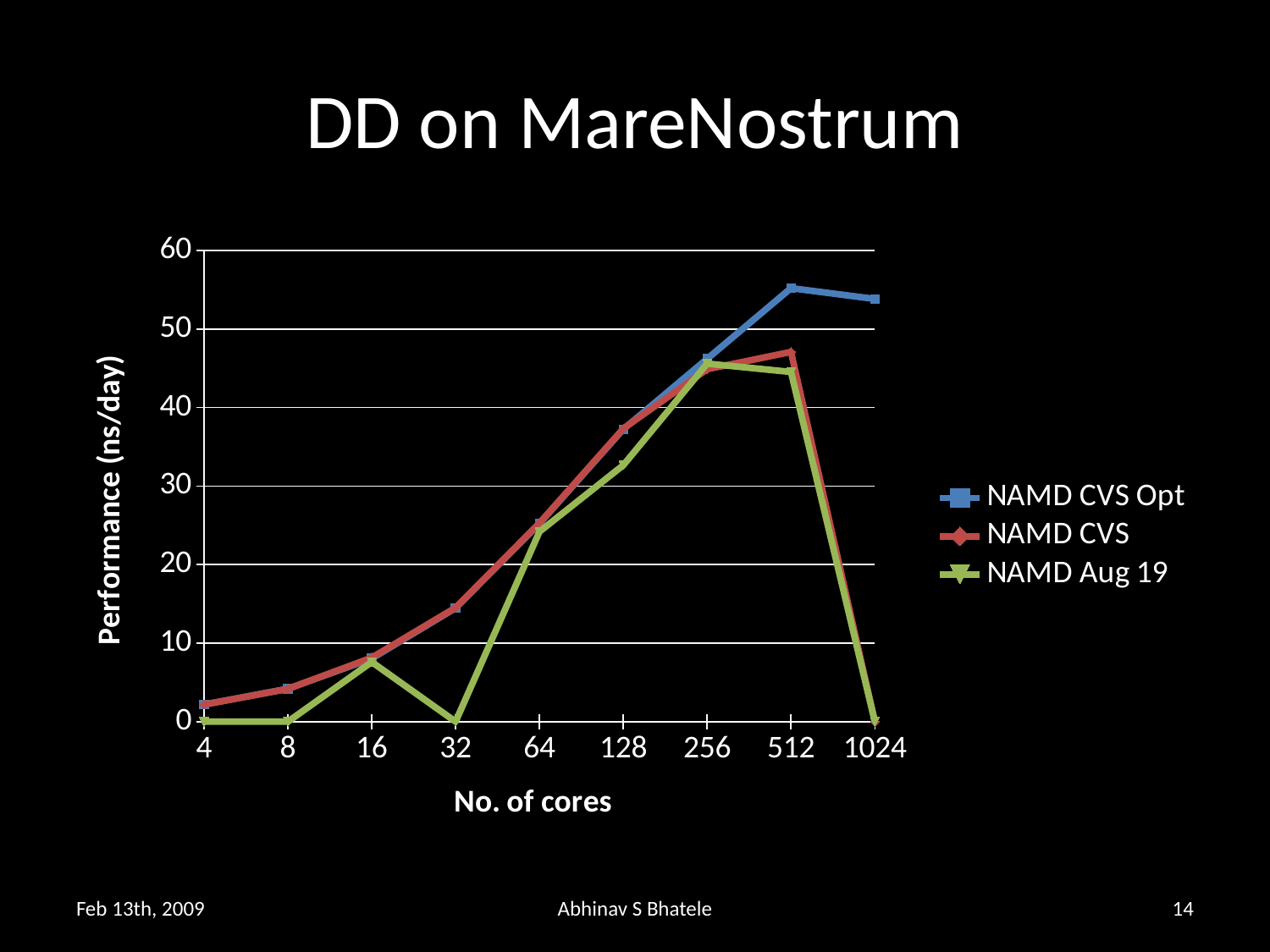
What kind of chart is shown on the slide? line chart How many core counts are shown along the x axis? 9 Does the performance of NAMD CVS Opt rise or fall from 4 cores to 512 cores? rise At which number of cores does NAMD CVS Opt reach its highest performance? 512 What is the label of the y axis? Performance (ns/day) Is the value for NAMD CVS Opt at 512 cores greater or less than 50? greater What is the performance of NAMD CVS at 1024 cores? 0 At 512 cores, which series has the higher performance, NAMD CVS Opt or NAMD CVS? NAMD CVS Opt What is the performance of NAMD Aug 19 at 32 cores? 0 How many series does the legend list? 3 Which series is drawn in green? NAMD Aug 19 Is the value for NAMD CVS at 128 cores greater or less than 40? less